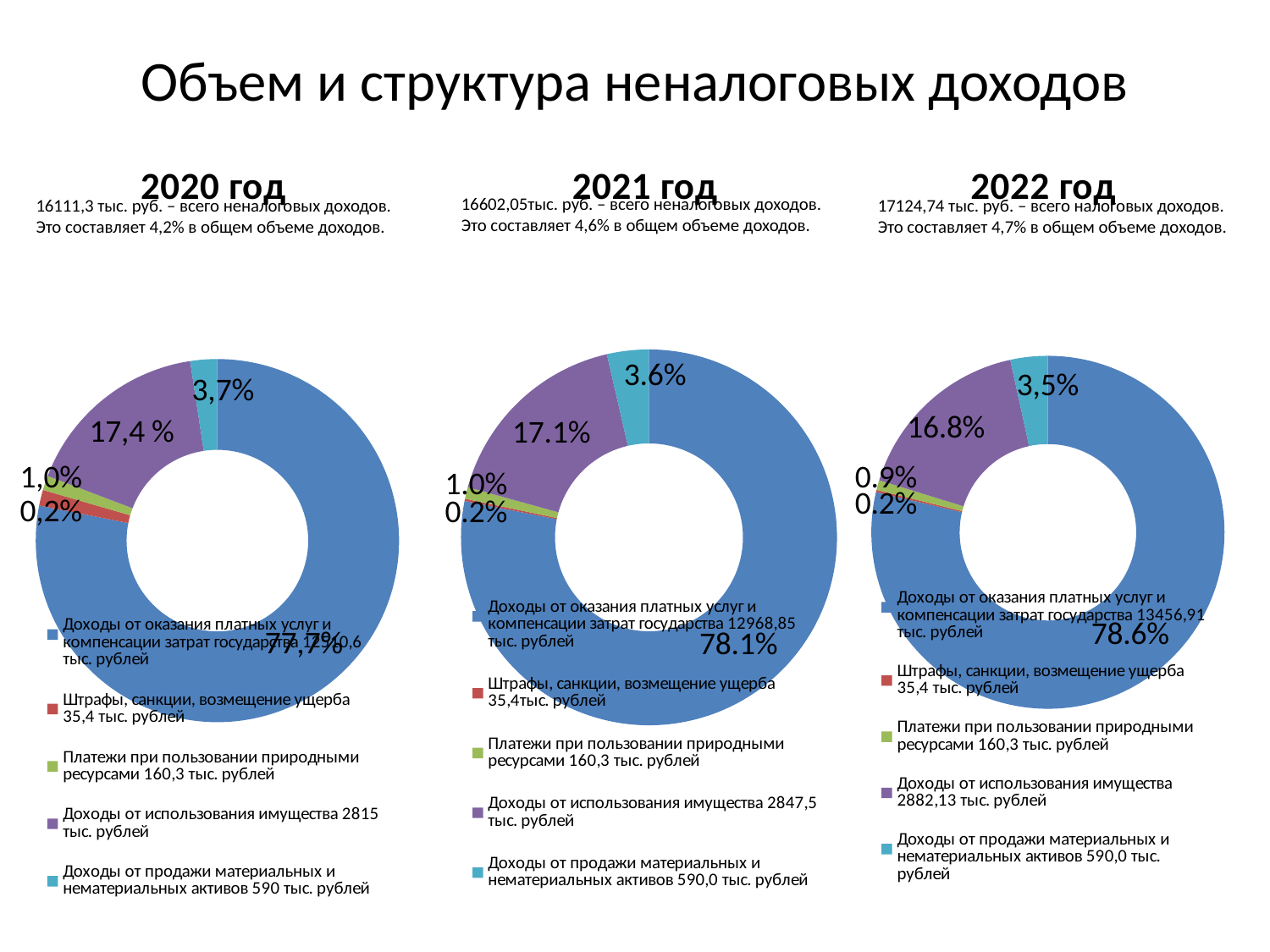
In the 2021 год chart, what is the difference in percentage points between the 78.1% slice and the 17.1% slice? 61.0 In the 2022 год chart, what share is shown for Доходы от использования имущества? 16.8% In the 2022 год chart, which is larger: the share for Доходы от использования имущества or the share for Доходы от продажи материальных и нематериальных активов? Доходы от использования имущества What type of chart is used for the 2020 год data? Doughnut (pie) chart In the 2021 год chart, what share is shown for the largest slice (Доходы от оказания платных услуг и компенсации затрат государства)? 78.1% In the 2022 год chart, what share is shown for Штрафы, санкции, возмещение ущерба? 0.2% In the 2020 год chart, what share is shown for Доходы от продажи материальных и нематериальных активов? 3,7% In the 2020 год chart, which category has the largest share? Доходы от оказания платных услуг и компенсации затрат государства What is the title of the slide containing the three charts? Объем и структура неналоговых доходов In the 2021 год chart, what share is shown for Платежи при пользовании природными ресурсами? 1.0% How many categories does the legend of the 2021 год chart list? 5 In the 2022 год chart, which category has the smallest share? Штрафы, санкции, возмещение ущерба